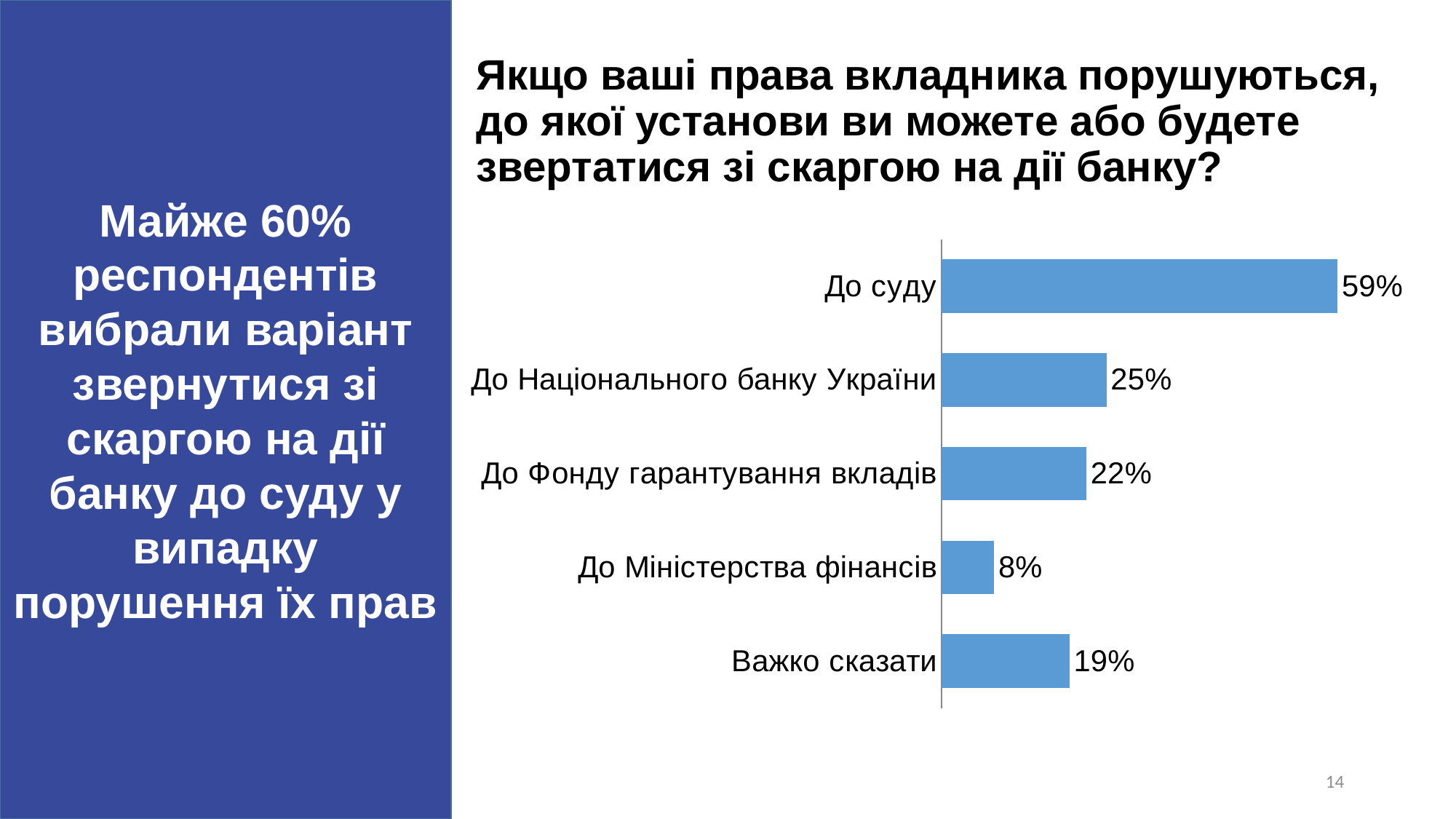
What kind of chart is shown on the slide? Bar chart What is the value for "До Фонду гарантування вкладів"? 22% How many categories are shown in the chart? 5 What is the value for "До суду"? 59% Which category has the lowest value? До Міністерства фінансів What is the value for "До Міністерства фінансів"? 8% Which category has the highest value? До суду What is the value for "До Національного банку України"? 25% What is the difference between the values for "До суду" and "До Національного банку України"? 34% What is the title of the chart? Якщо ваші права вкладника порушуються, до якої установи ви можете або будете звертатися зі скаргою на дії банку? What is the value for "Важко сказати"? 19% Which is larger: the value for "До Фонду гарантування вкладів" or "Важко сказати"? До Фонду гарантування вкладів